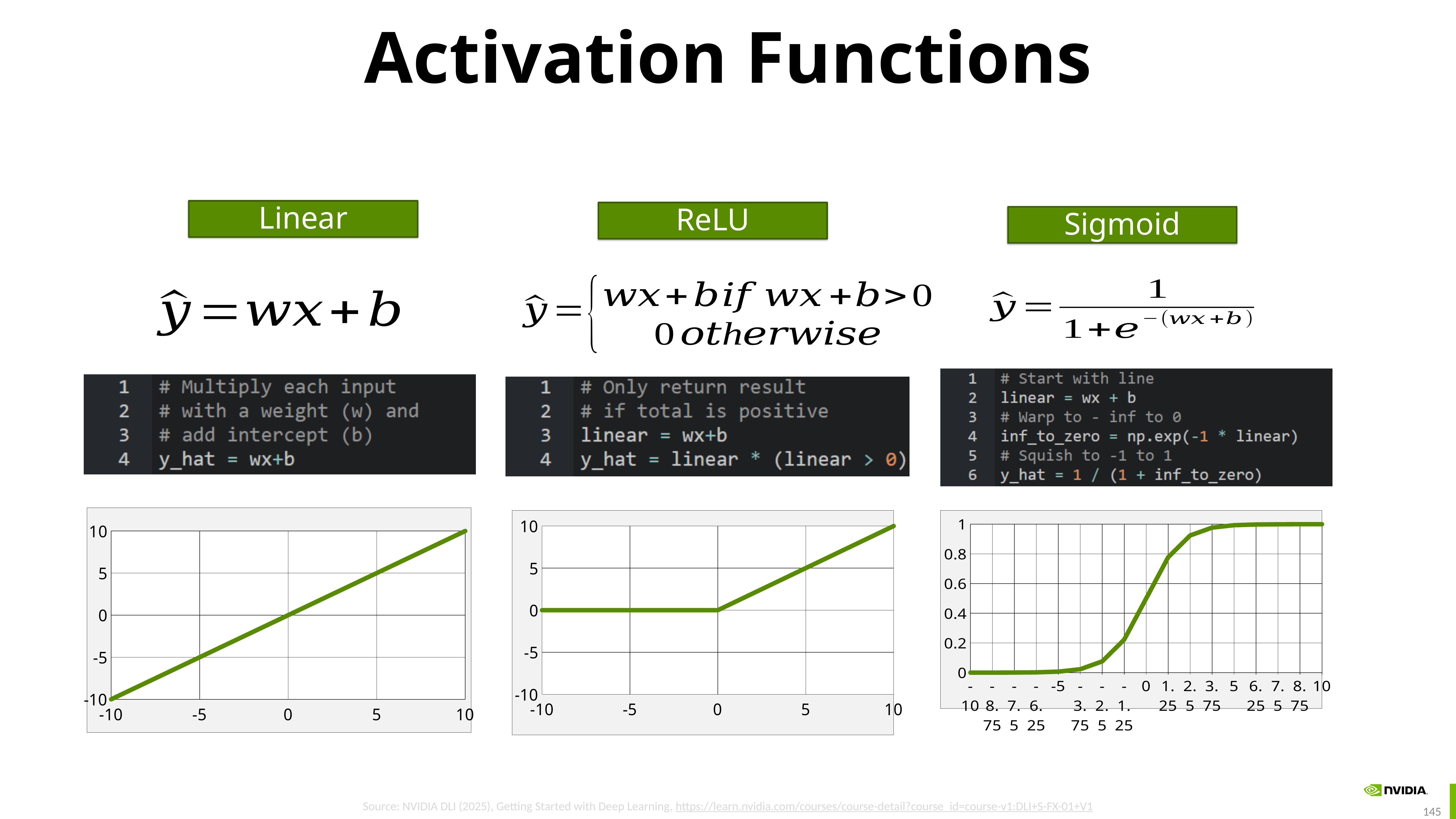
What colour is the plotted line in the three charts? green In the ReLU chart, what is the y value at x = -5? 0 In the Sigmoid chart, is the y value at x = -5 greater or less than 0.2? less In the Linear chart, what is the y value at x = -10? -10 What kind of chart is the Linear chart on the left? line chart In the Linear chart, what is the y value at x = 10? 10 In the Linear chart, which is larger: the y value at x = 5 or the y value at x = -5? x = 5 In the ReLU chart, what is the y value at x = 10? 10 In the Sigmoid chart, do the values rise or fall as x increases? rise In the Linear chart, do the values rise or fall as x increases from -10 to 10? rise In the ReLU chart, is the y value at x = 5 greater or less than 0? greater In the Sigmoid chart, is the y value at x = 5 greater or less than 0.8? greater